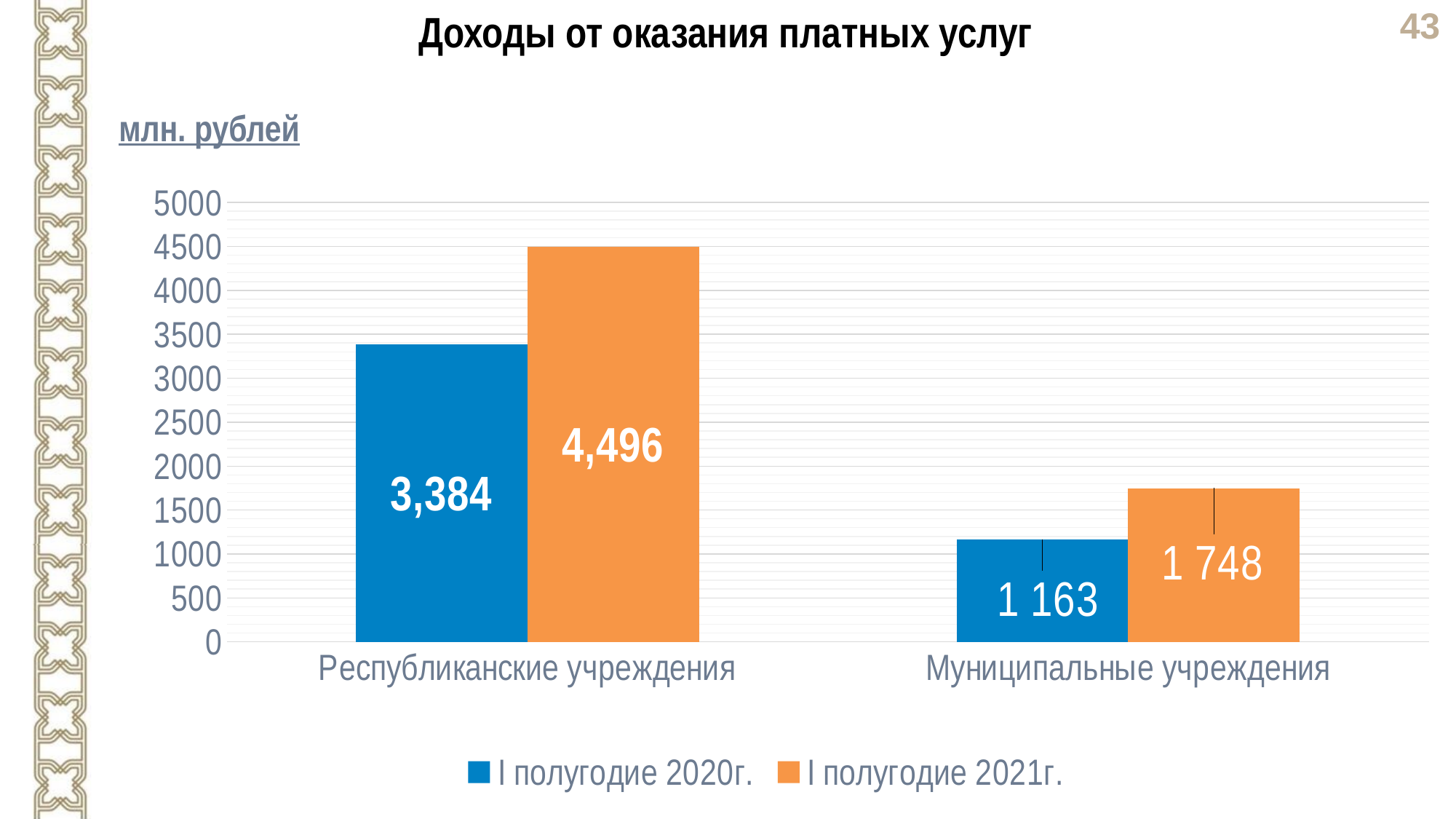
What type of chart is shown on the slide? Bar chart Which is larger for Муниципальные учреждения: I полугодие 2020г. or I полугодие 2021г.? I полугодие 2021г. How many categories are shown on the x axis? 2 How many series does the legend list? 2 Which bar has the lowest value on the chart? Муниципальные учреждения, I полугодие 2020г. What is the difference between the I полугодие 2021г. and I полугодие 2020г. values for Республиканские учреждения? 1,112 What is the value for Муниципальные учреждения in I полугодие 2021г.? 1 748 What is the value for Муниципальные учреждения in I полугодие 2020г.? 1 163 What is the value for Республиканские учреждения in I полугодие 2020г.? 3,384 What is the value for Республиканские учреждения in I полугодие 2021г.? 4,496 Which bar has the highest value on the chart? Республиканские учреждения, I полугодие 2021г. What is the difference between the I полугодие 2021г. and I полугодие 2020г. values for Муниципальные учреждения? 585